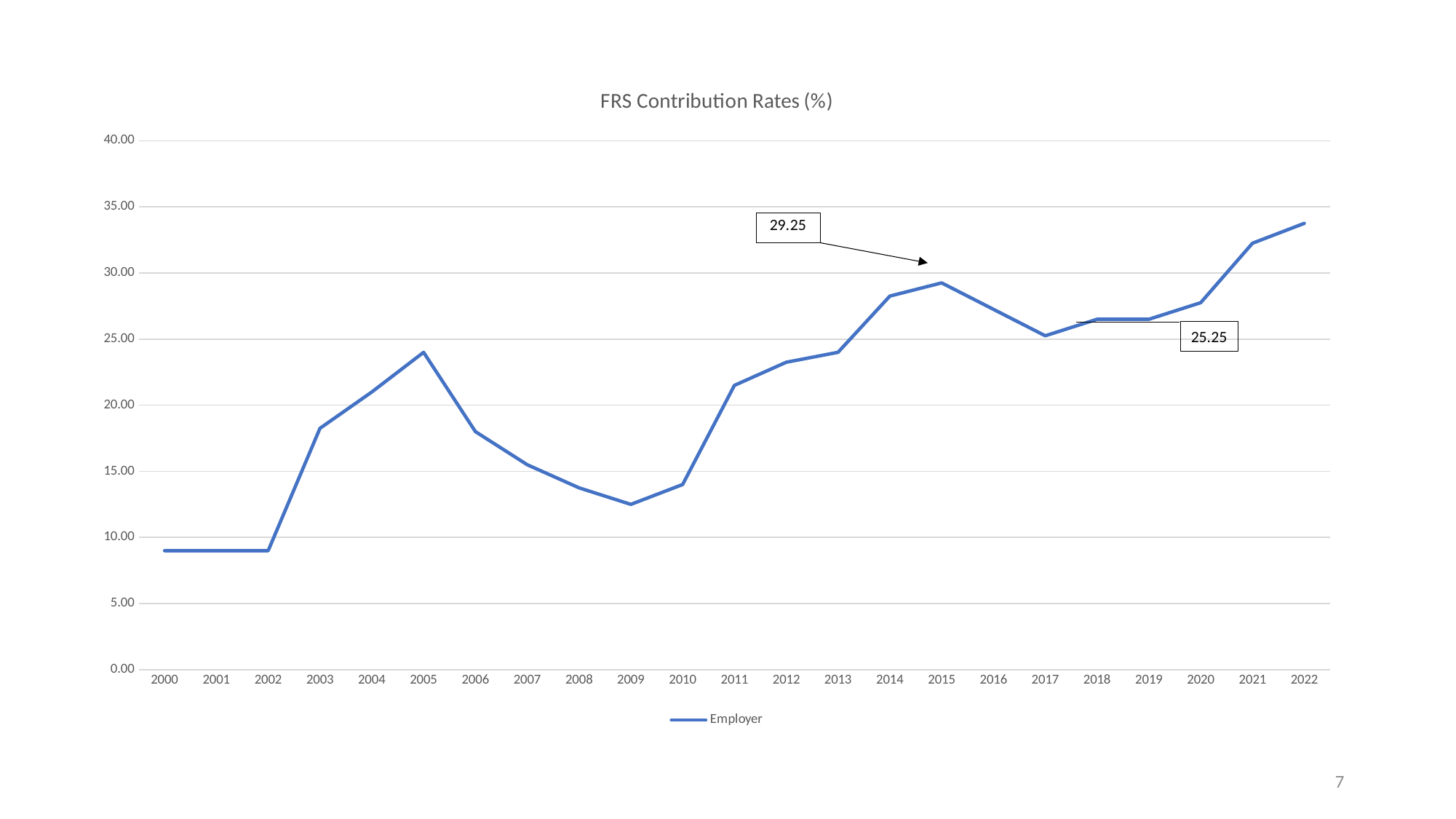
Is the value for 2009 greater or less than 15.00? less How many series does the legend list? 1 Which year has the larger Employer contribution rate, 2005 or 2010? 2005 How many years are plotted along the x axis? 23 What is the annotated Employer contribution rate for 2015? 29.25 What is the title of the chart? FRS Contribution Rates (%) Is the value for 2005 greater or less than 20.00? greater Which year has the highest Employer contribution rate? 2022 What kind of chart is shown on the slide? Line chart Is the value for 2021 greater or less than 30.00? greater What is the name of the series shown in the legend? Employer Does the Employer contribution rate rise or fall from 2005 to 2009? Fall